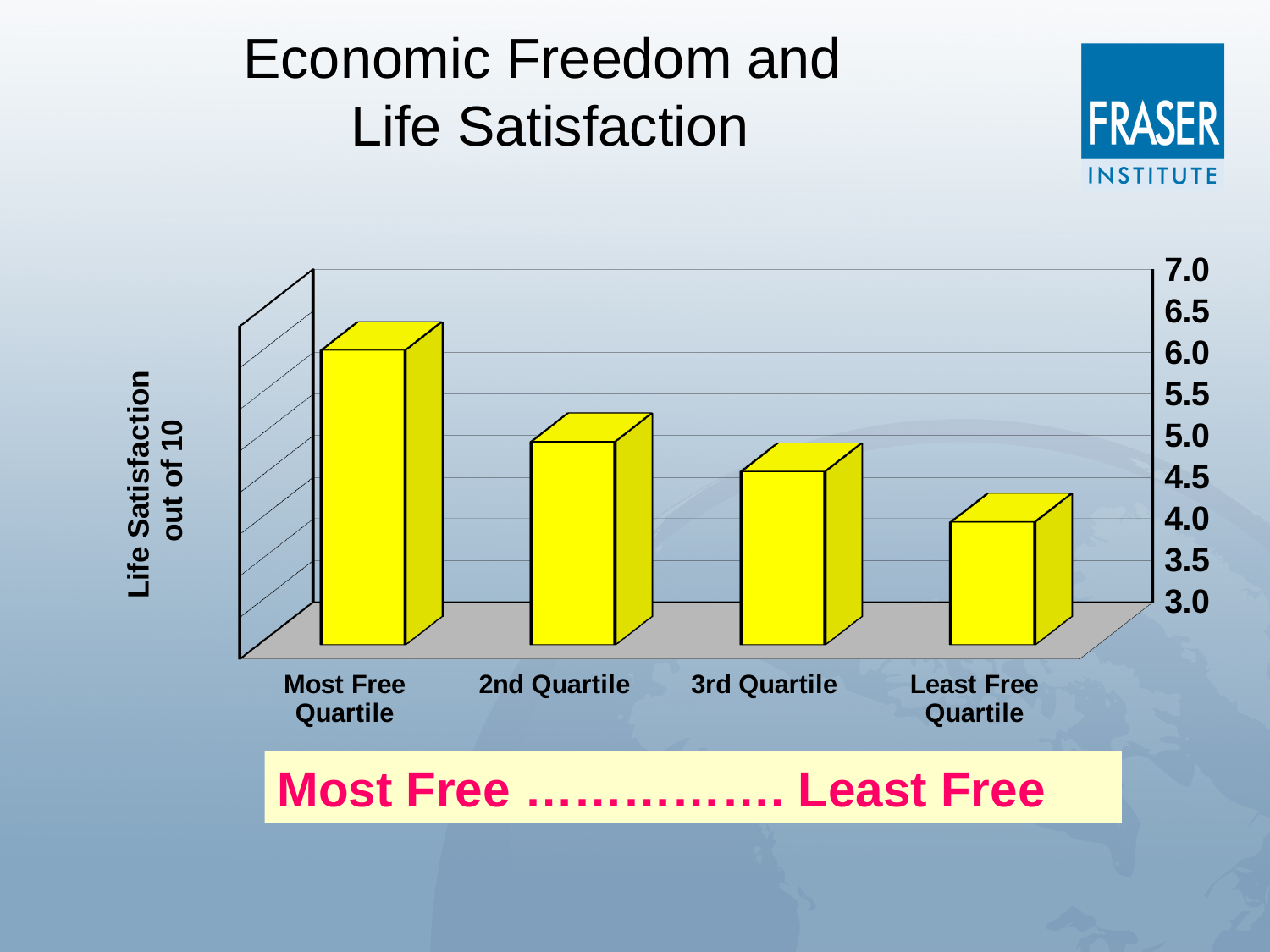
What is the label on the vertical axis of the chart? Life Satisfaction out of 10 Which quartile has the highest life satisfaction? Most Free Quartile What is the title of the chart on the slide? Economic Freedom and Life Satisfaction Is the value for the Most Free Quartile greater or less than 5.5? greater How many quartile categories are plotted on the chart? 4 Which quartile has the lowest life satisfaction? Least Free Quartile Is the value for the 2nd Quartile greater or less than 5.5? less Do the values rise or fall moving from the Most Free Quartile to the Least Free Quartile? fall Is the value for the 3rd Quartile greater or less than 4.0? greater What kind of chart is shown on the slide? bar chart Which has a higher life satisfaction, the 2nd Quartile or the Least Free Quartile? 2nd Quartile